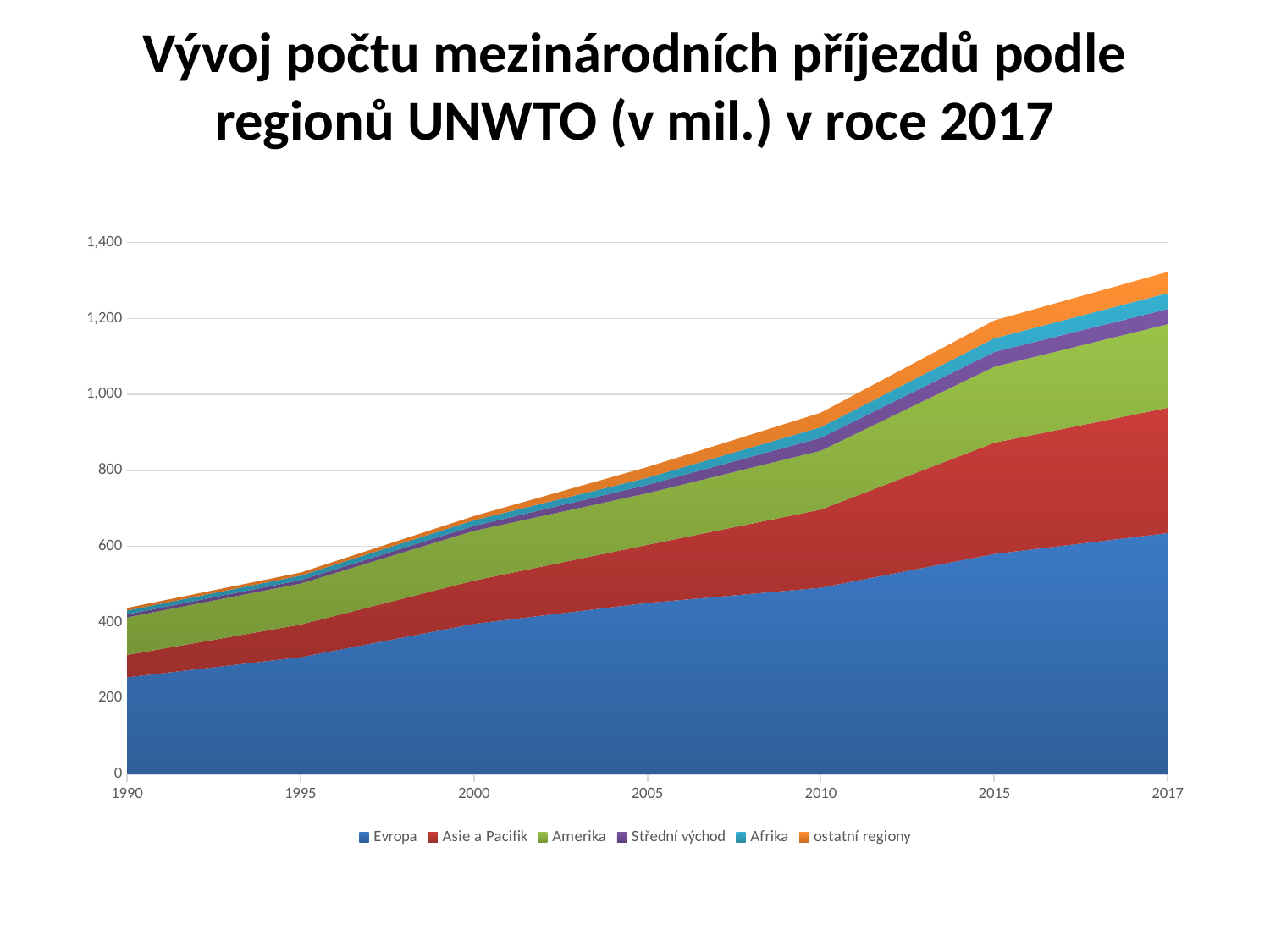
What is the first series listed in the legend? Evropa Is the value for Evropa in 1990 greater or less than 200? greater How many years are marked on the x axis? 7 In 2017, which is larger: the value for Evropa or the value for Asie a Pacifik? Evropa Is the stacked total for 2017 greater or less than 1,200? greater What is the title of the chart? Vývoj počtu mezinárodních příjezdů podle regionů UNWTO (v mil.) v roce 2017 How many series does the legend list? 6 Is the value for Evropa in 2017 greater or less than 600? greater Does the total number of international arrivals rise or fall from 1990 to 2017? rise Which region has the largest band in the chart? Evropa What kind of chart is shown on the slide? stacked area chart